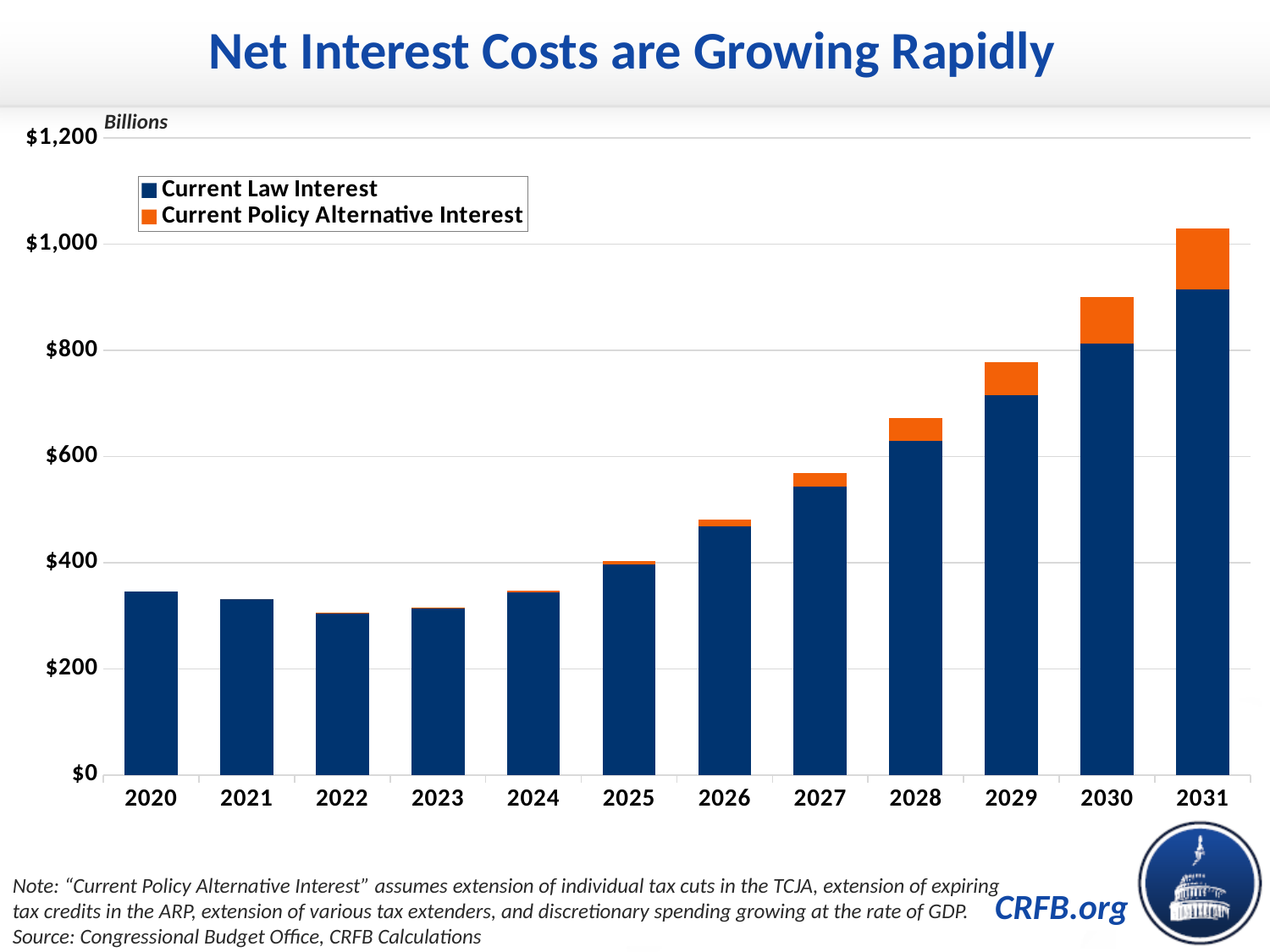
Do the total net interest costs rise or fall from 2024 to 2031? rise How many series does the legend list? 2 Is the total value for 2031 greater or less than $1,000? greater Which is larger, the total for 2025 or the total for 2024? 2025 Is the total value for 2026 greater or less than $600? less Which series is shown in orange? Current Policy Alternative Interest What kind of chart is shown on the slide? bar chart What is the title of the chart? Net Interest Costs are Growing Rapidly Is the total value for 2028 greater or less than $600? greater How many years are shown along the x axis? 12 Which year has the highest total net interest cost? 2031